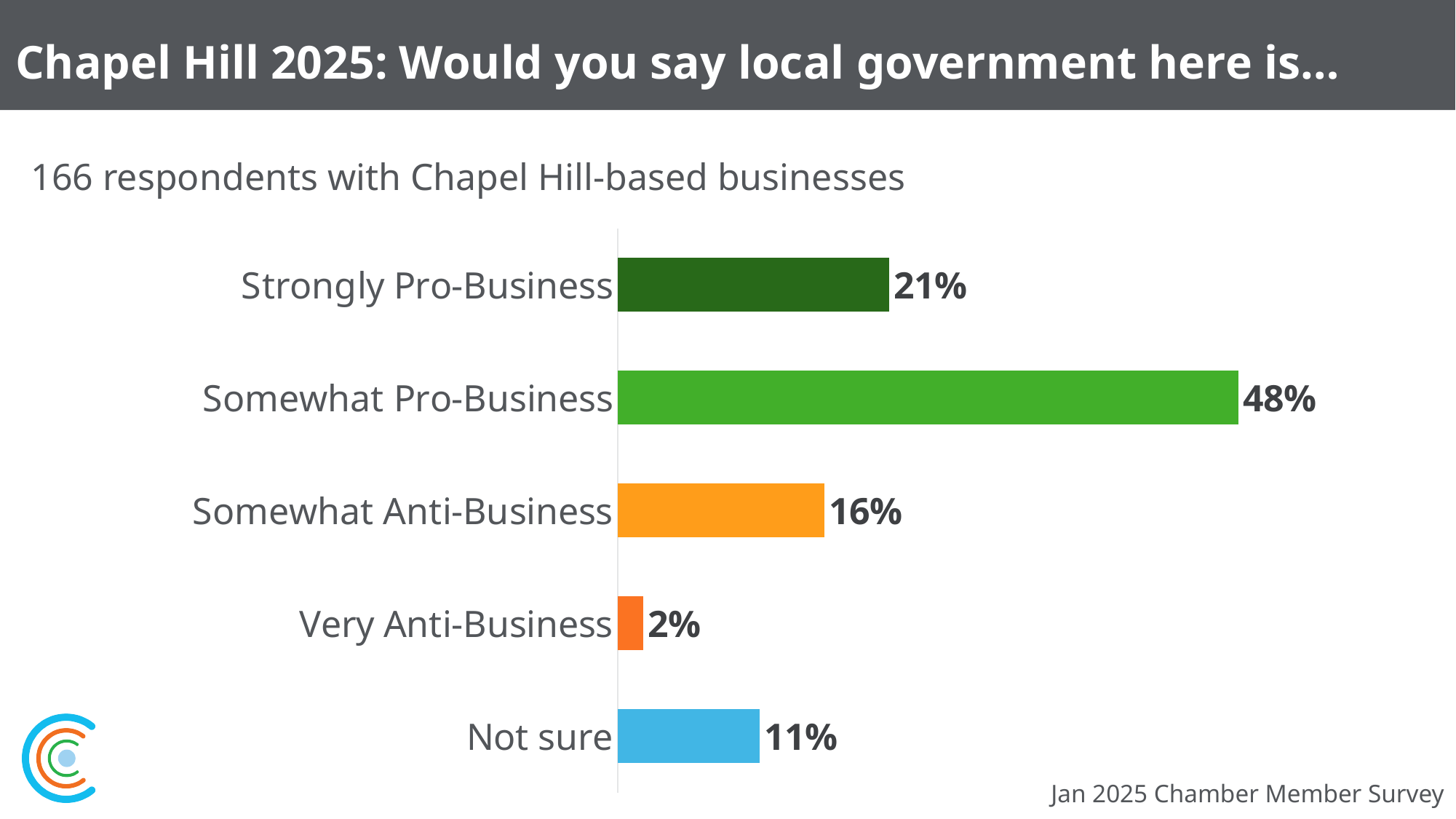
What type of chart is shown on the slide? Bar chart What percentage of respondents answered Not sure? 11% What percentage of respondents said local government is Strongly Pro-Business? 21% How many response categories are shown in the chart? 5 What percentage of respondents said local government is Somewhat Pro-Business? 48% What is the difference in percentage points between Somewhat Pro-Business and Strongly Pro-Business? 27 Which response category has the lowest percentage? Very Anti-Business What percentage of respondents said local government is Somewhat Anti-Business? 16% Which is larger, the percentage for Somewhat Anti-Business or for Not sure? Somewhat Anti-Business How many respondents with Chapel Hill-based businesses are reported on the slide? 166 Which response category has the highest percentage? Somewhat Pro-Business What colour is the bar for Not sure? Blue